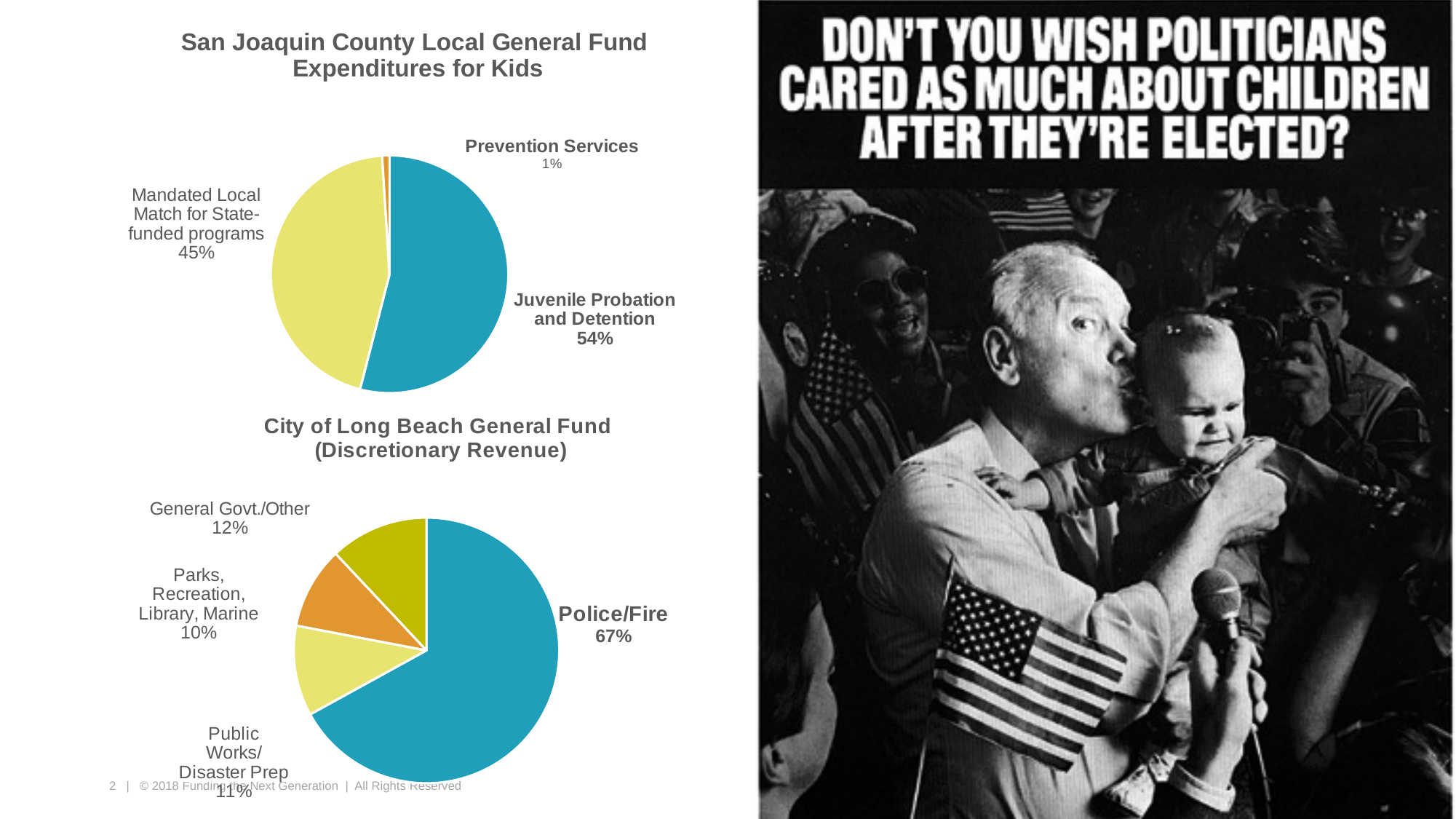
How many slices does the 'San Joaquin County Local General Fund Expenditures for Kids' chart have? 3 What type of chart is the 'City of Long Beach General Fund (Discretionary Revenue)' chart? Pie chart In the 'City of Long Beach General Fund (Discretionary Revenue)' chart, what share goes to Parks, Recreation, Library, Marine? 10% In the 'City of Long Beach General Fund (Discretionary Revenue)' chart, which is larger: General Govt./Other or Public Works/Disaster Prep? General Govt./Other In the 'San Joaquin County Local General Fund Expenditures for Kids' chart, what share goes to Juvenile Probation and Detention? 54% In the 'San Joaquin County Local General Fund Expenditures for Kids' chart, how many percentage points larger is Juvenile Probation and Detention than Mandated Local Match for State-funded programs? 9 percentage points In the 'San Joaquin County Local General Fund Expenditures for Kids' chart, which category has the smallest share? Prevention Services In the 'City of Long Beach General Fund (Discretionary Revenue)' chart, what share goes to Police/Fire? 67% In the 'City of Long Beach General Fund (Discretionary Revenue)' chart, what is the combined share of General Govt./Other and Public Works/Disaster Prep? 23% In the 'San Joaquin County Local General Fund Expenditures for Kids' chart, which category has the largest share? Juvenile Probation and Detention In the 'San Joaquin County Local General Fund Expenditures for Kids' chart, what share goes to Prevention Services? 1% How many slices does the 'City of Long Beach General Fund (Discretionary Revenue)' chart have? 4